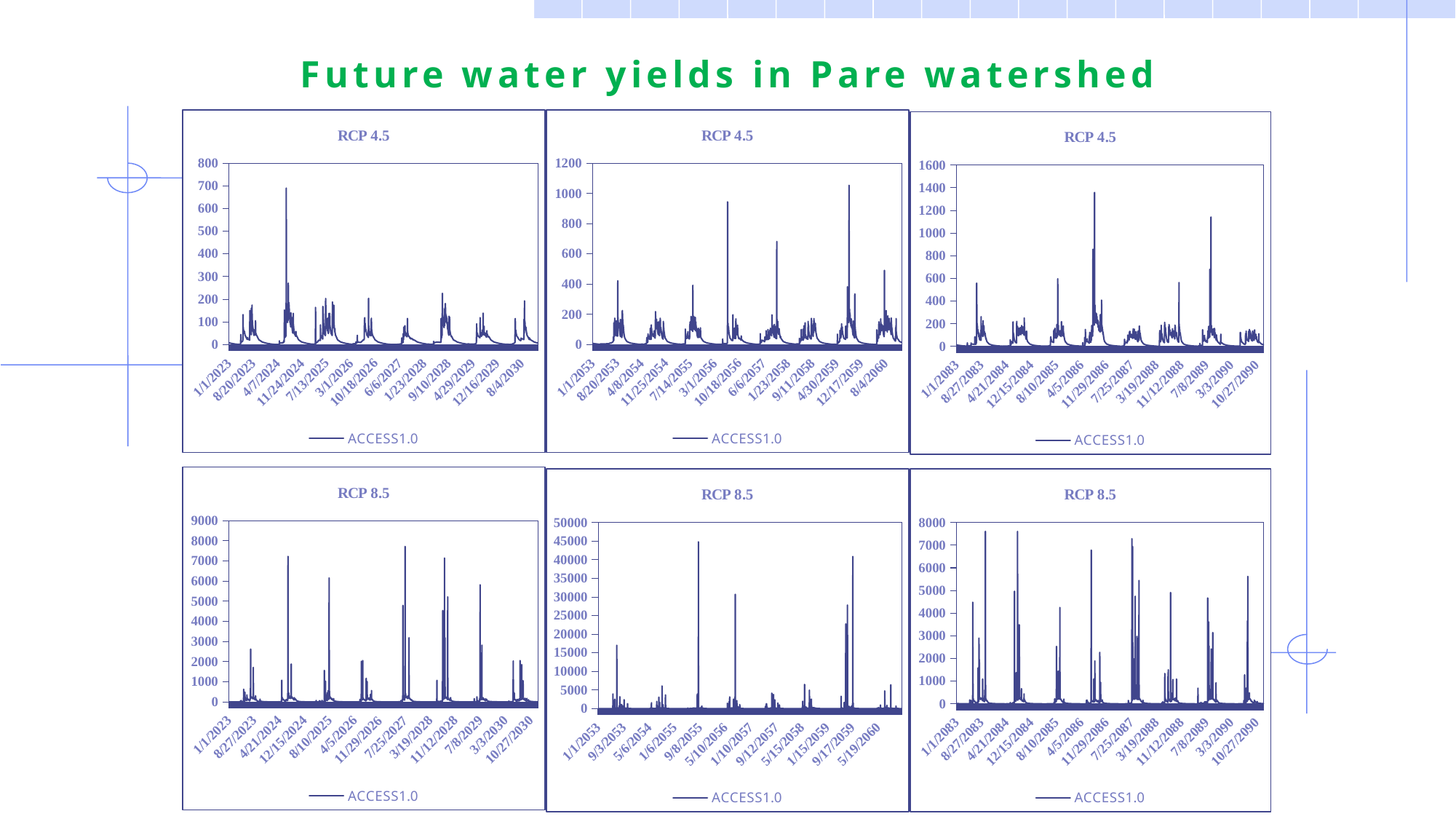
What is the name of the series shown in the legend of the top-right RCP 4.5 chart? ACCESS1.0 How many series does the legend of the bottom-middle RCP 8.5 chart list? 1 What kind of chart is the top-left chart titled RCP 4.5? line chart In the bottom-left RCP 8.5 chart, is the highest peak greater or less than 7000? greater In the top-left RCP 4.5 chart, is the highest peak greater or less than 600? greater In the bottom-right RCP 8.5 chart, is the highest peak greater or less than 7000? greater How many charts are shown on the slide? 6 What is the title of the slide? Future water yields in Pare watershed